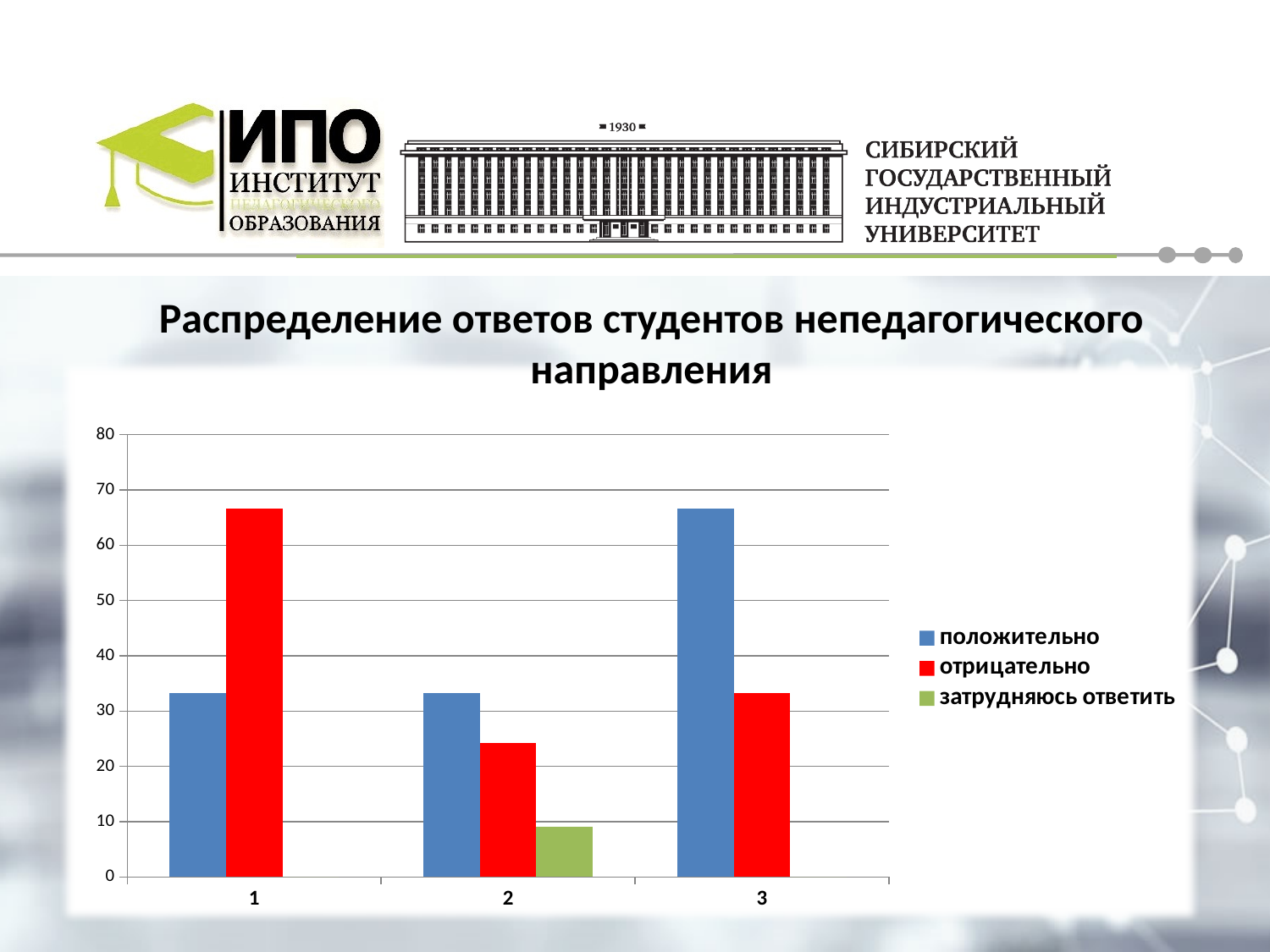
Is the value for "положительно" in category 1 greater or less than 40? less How many series does the legend list? 3 What kind of chart is shown on the slide? bar chart What is the title of the chart? Распределение ответов студентов непедагогического направления In category 2, which series has the highest value? положительно How many categories are shown on the x axis? 3 Is the value for "положительно" in category 3 greater or less than 60? greater In category 3, which is larger: the value for "положительно" or the value for "отрицательно"? положительно Which colour represents the series "отрицательно" in the legend? red Is the value for "отрицательно" in category 1 greater or less than 60? greater In category 2, which series has the lowest value? затрудняюсь ответить